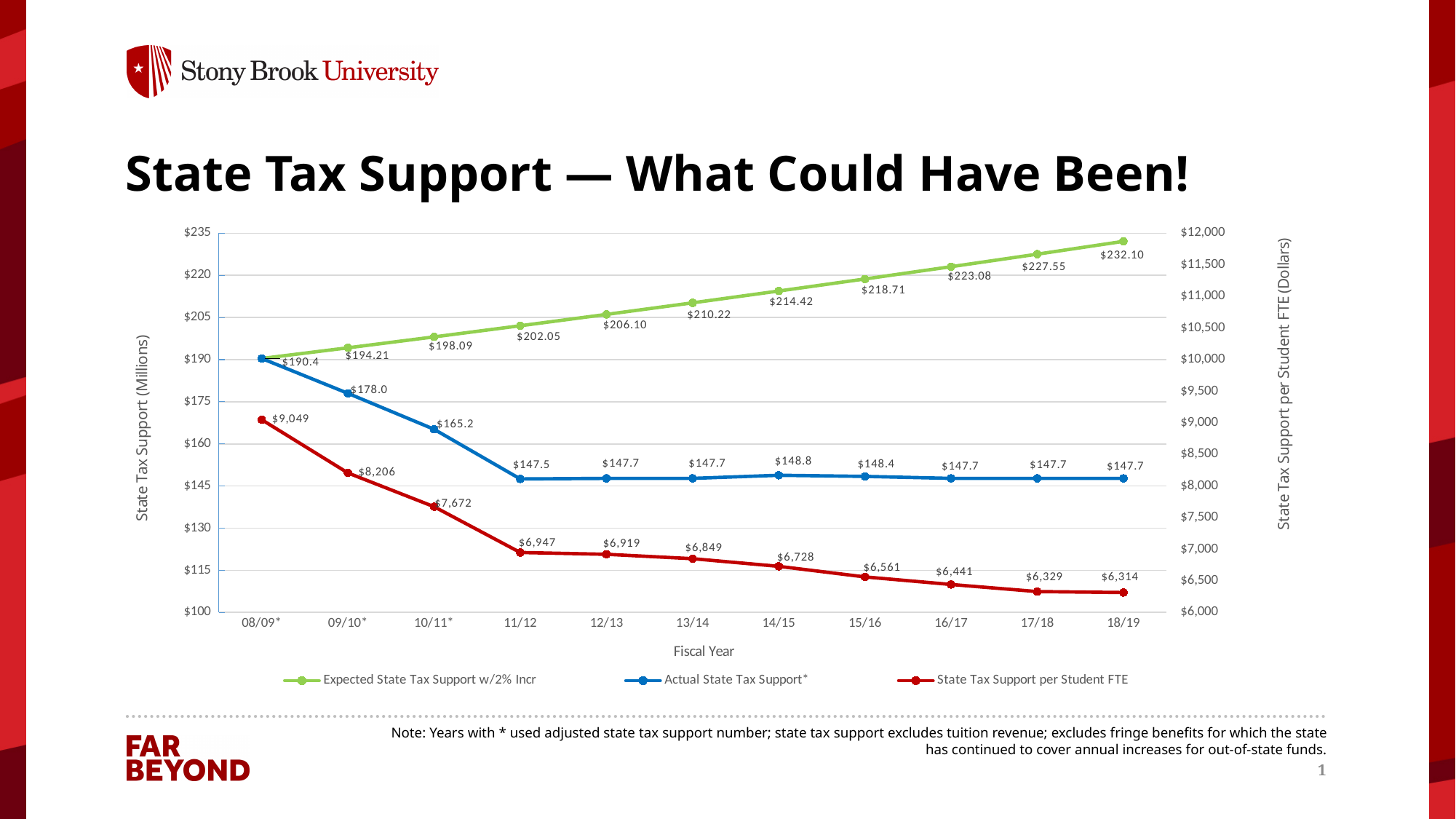
How many series does the legend list? 3 In which fiscal year is State Tax Support per Student FTE lowest? 18/19 What is the difference between Expected State Tax Support w/2% Incr and Actual State Tax Support in fiscal year 18/19? $84.40 Does the Expected State Tax Support w/2% Incr series rise or fall from 08/09* to 18/19? Rise What is the Actual State Tax Support value for fiscal year 10/11*? $165.2 Which fiscal year has the higher Actual State Tax Support value, 14/15 or 15/16? 14/15 In which fiscal year is State Tax Support per Student FTE highest? 08/09* By how much did State Tax Support per Student FTE decrease from 08/09* to 18/19? $2,735 What is the State Tax Support per Student FTE value for fiscal year 08/09*? $9,049 How many fiscal years are shown on the x axis? 11 What is the Expected State Tax Support w/2% Incr value for fiscal year 18/19? $232.10 What kind of chart is shown on the slide? Line chart